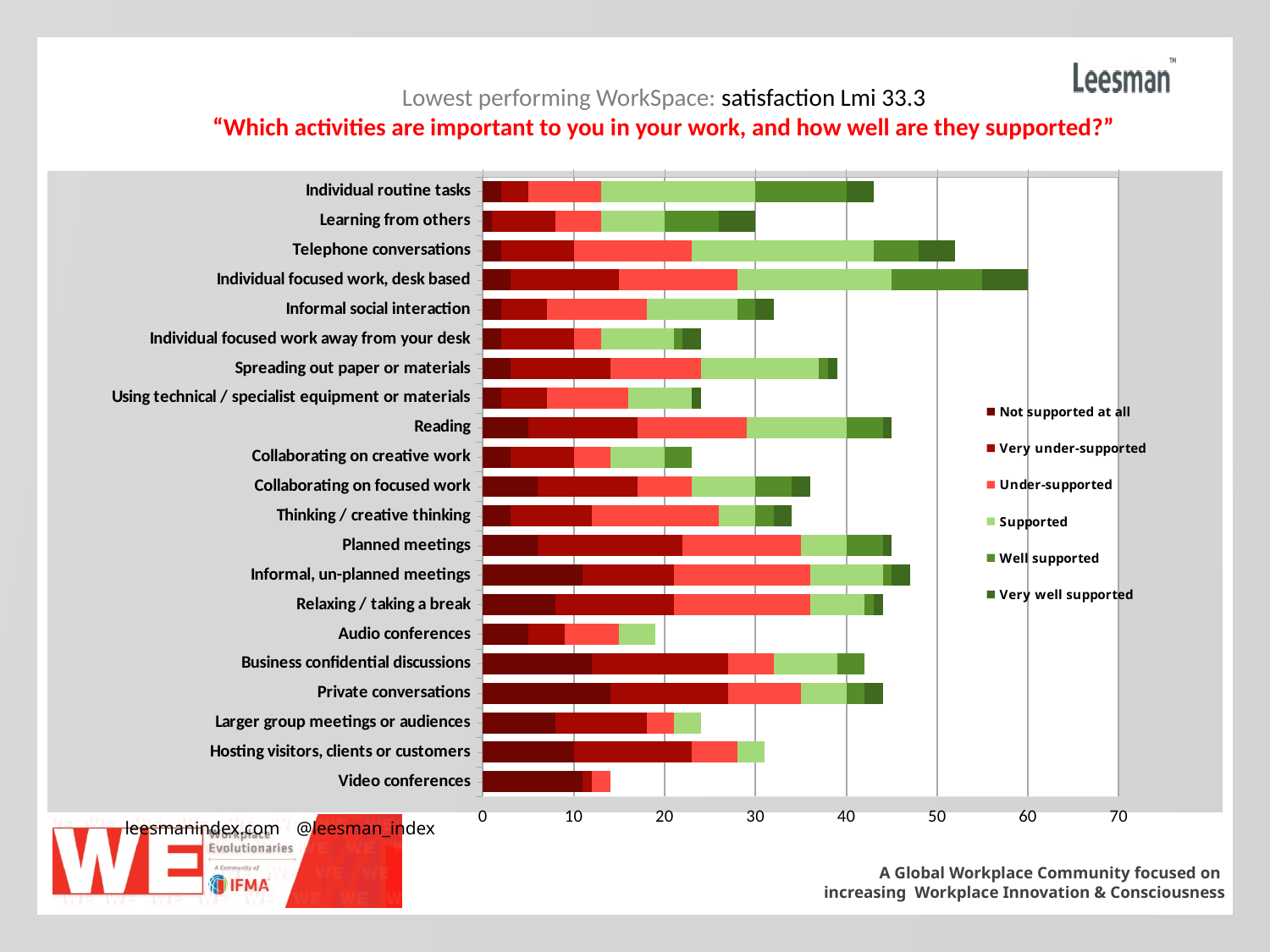
Is the total bar for Audio conferences greater or less than 20? less How many activity categories are plotted on the chart? 21 Which has the longer total bar, Audio conferences or Video conferences? Audio conferences Which activity has the shortest total bar? Video conferences What kind of chart is shown on the slide? Stacked bar chart Which has the longer total bar, Telephone conversations or Reading? Telephone conversations Is the total bar for Video conferences greater or less than 10? greater Is the total bar for Planned meetings greater or less than 40? greater Which activity has the longest total bar? Individual focused work, desk based Which legend entry is shown in the darkest red colour? Not supported at all How many series does the legend list? 6